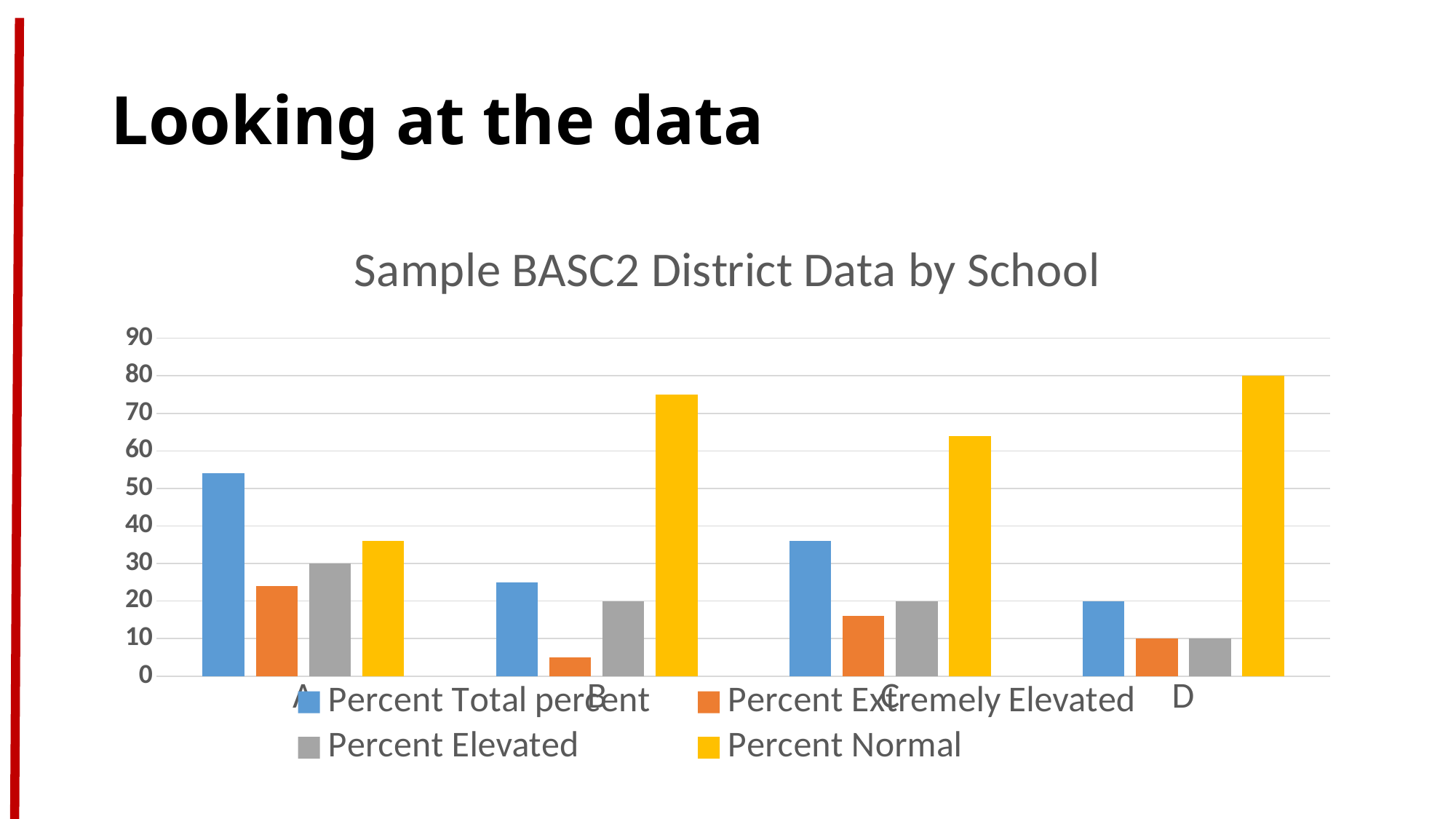
How many series does the legend of the chart list? 4 What kind of chart is shown on the slide? bar chart Is the Percent Normal value for school B greater or less than 70? greater How many schools (categories) are shown on the x axis of the chart? 4 Which school has the highest Percent Normal value? D Which school has the highest Percent Total percent value? A Which school has the larger Percent Total percent value, A or C? A What is the Percent Normal value for school D? 80 What is the title of the chart? Sample BASC2 District Data by School Which school has the lowest Percent Normal value? A Which colour represents the Percent Normal series in the chart? yellow Is the Percent Extremely Elevated value for school B greater or less than 10? less